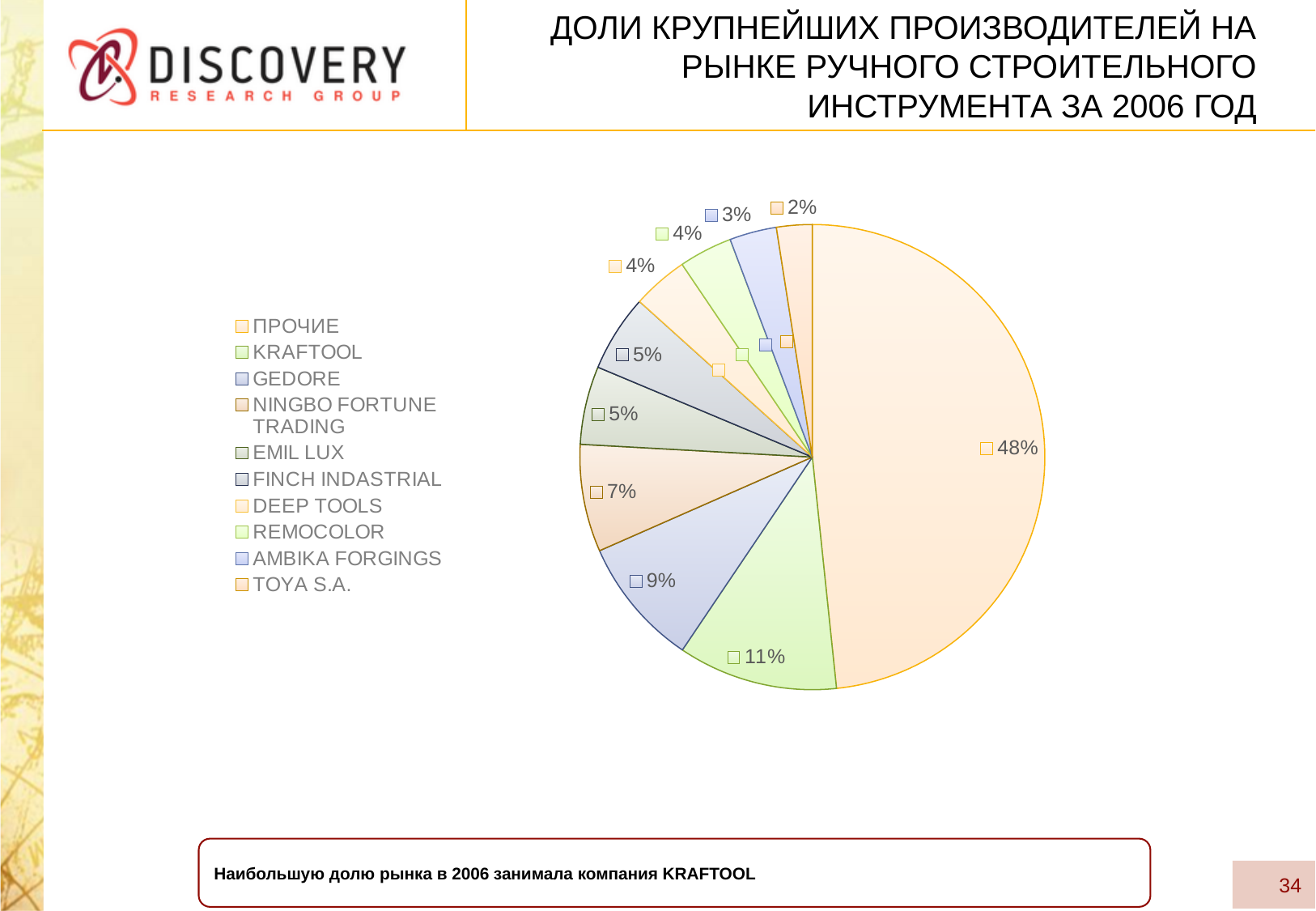
What is the difference between the shares of KRAFTOOL and GEDORE? 2% What share of the market does KRAFTOOL hold in the pie chart? 11% How many slices does the pie chart have? 10 What share is shown for NINGBO FORTUNE TRADING? 7% What is the combined share of EMIL LUX and FINCH INDASTRIAL? 10% Which slice of the pie chart is the largest? ПРОЧИЕ (48%) Which has a larger share, GEDORE or NINGBO FORTUNE TRADING? GEDORE What share is shown for GEDORE? 9% Which named company has the smallest share in the pie chart? TOYA S.A. What share is shown for TOYA S.A.? 2% What share is shown for AMBIKA FORGINGS? 3% What type of chart is shown on the slide? pie chart